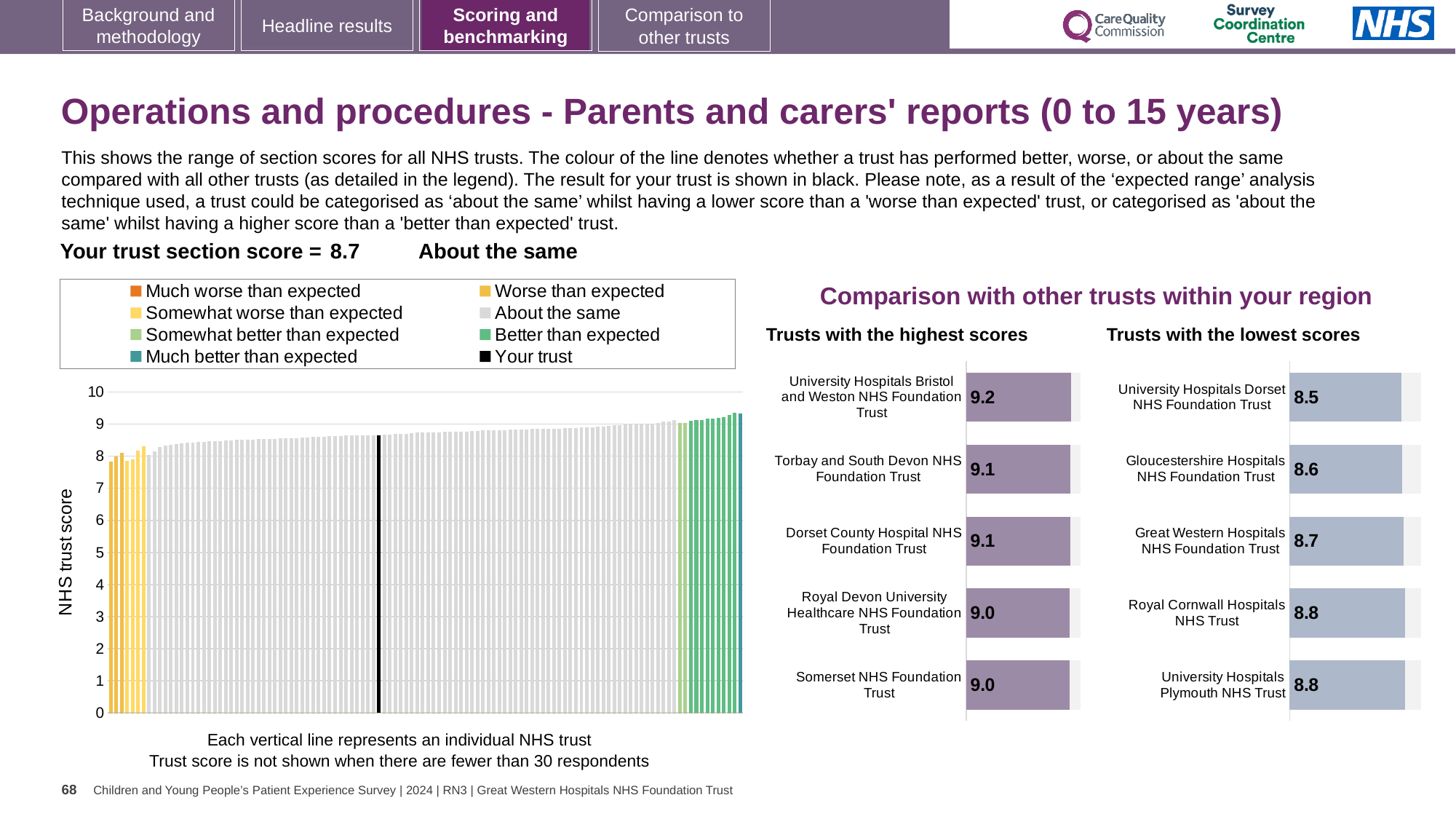
In the 'Trusts with the lowest scores' chart, which trust has the lowest score? University Hospitals Dorset NHS Foundation Trust How many entries does the legend above the 'NHS trust score' chart list? 8 In the 'NHS trust score' chart, what is the highest value shown on the y-axis? 10 In the 'Trusts with the lowest scores' chart, what is the value for Great Western Hospitals NHS Foundation Trust? 8.7 In the 'Trusts with the lowest scores' chart, which has the larger score: Gloucestershire Hospitals NHS Foundation Trust or Royal Cornwall Hospitals NHS Trust? Royal Cornwall Hospitals NHS Trust In the 'Trusts with the highest scores' chart, what is the difference between the scores of University Hospitals Bristol and Weston NHS Foundation Trust and Royal Devon University Healthcare NHS Foundation Trust? 0.2 What type of chart is the large chart on the left with the y-axis labelled 'NHS trust score'? Bar chart How many trusts are shown in the 'Trusts with the lowest scores' chart? 5 In the 'Trusts with the highest scores' chart, what is the value for Somerset NHS Foundation Trust? 9.0 In the 'Trusts with the highest scores' chart, which trust has the highest score? University Hospitals Bristol and Weston NHS Foundation Trust In the 'Trusts with the highest scores' chart, what is the value for University Hospitals Bristol and Weston NHS Foundation Trust? 9.2 In the 'NHS trust score' chart, is the value for the black bar (Your trust) greater or less than 8? greater